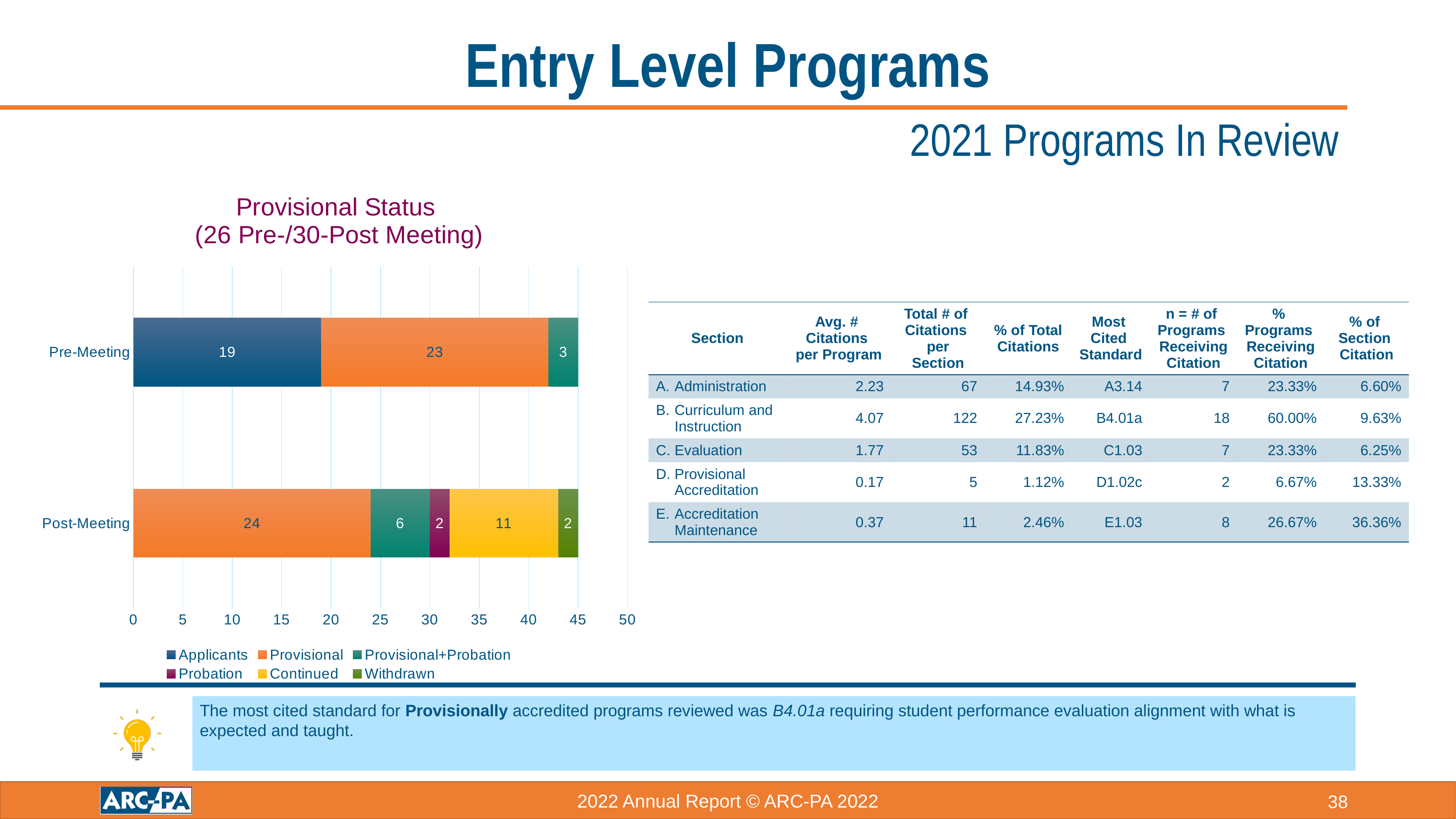
Which segment is the largest in the Post-Meeting bar? Provisional What is the value for Provisional in the Post-Meeting bar? 24 How many series does the legend list? 6 What is the total of the Post-Meeting stacked bar? 45 What is the title of the chart? Provisional Status (26 Pre-/30-Post Meeting) Which is larger, the Provisional+Probation value for Pre-Meeting or for Post-Meeting? Post-Meeting What kind of chart is shown on the slide? Stacked bar chart What is the value for Applicants in the Pre-Meeting bar? 19 What is the value for Continued in the Post-Meeting bar? 11 What is the difference between the Provisional values for Post-Meeting and Pre-Meeting? 1 What is the total of the Pre-Meeting stacked bar? 45 What is the value for Provisional+Probation in the Pre-Meeting bar? 3